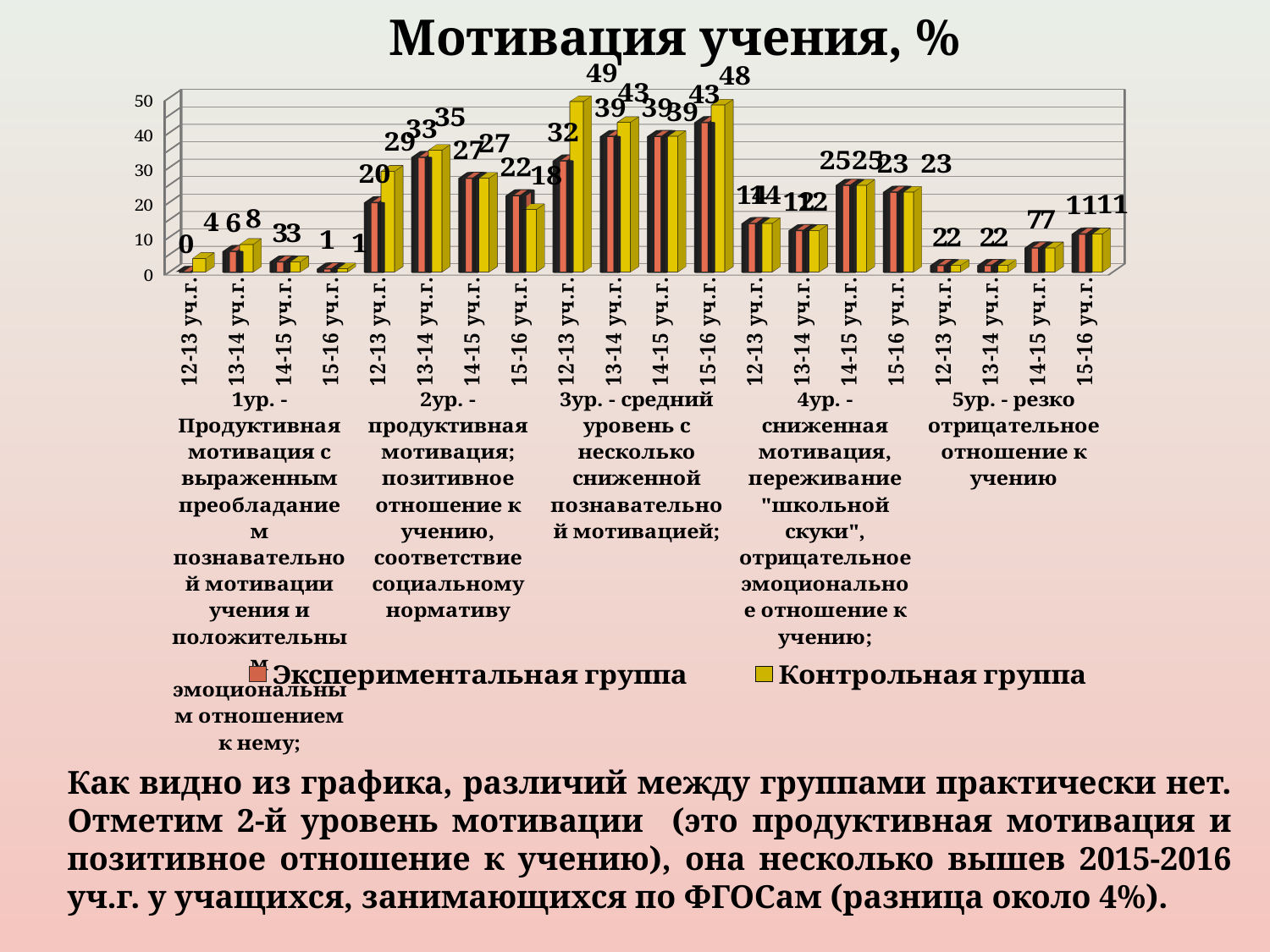
What is the difference between Контрольная группа and Экспериментальная группа in 12-13 уч.г. at 2ур. (продуктивная мотивация)? 9 How many series does the legend list? 2 What is the difference between Контрольная группа and Экспериментальная группа in 12-13 уч.г. at 3ур. (средний уровень)? 17 What is the value for Экспериментальная группа in 12-13 уч.г. at 2ур. (продуктивная мотивация)? 20 What is the value for Контрольная группа in 13-14 уч.г. at 2ур. (продуктивная мотивация)? 35 What are the two series named in the legend? Экспериментальная группа and Контрольная группа What kind of chart is shown on the slide? bar chart What is the value for Экспериментальная группа in 15-16 уч.г. at 3ур. (средний уровень)? 43 What is the value for Контрольная группа in 12-13 уч.г. at 3ур. (средний уровень)? 49 What is the value for Экспериментальная группа in 12-13 уч.г. at 1ур. (продуктивная мотивация с выраженным преобладанием)? 0 In 15-16 уч.г. at 2ур. (продуктивная мотивация), which group has the larger value? Экспериментальная группа What is the highest value shown on the chart? 49